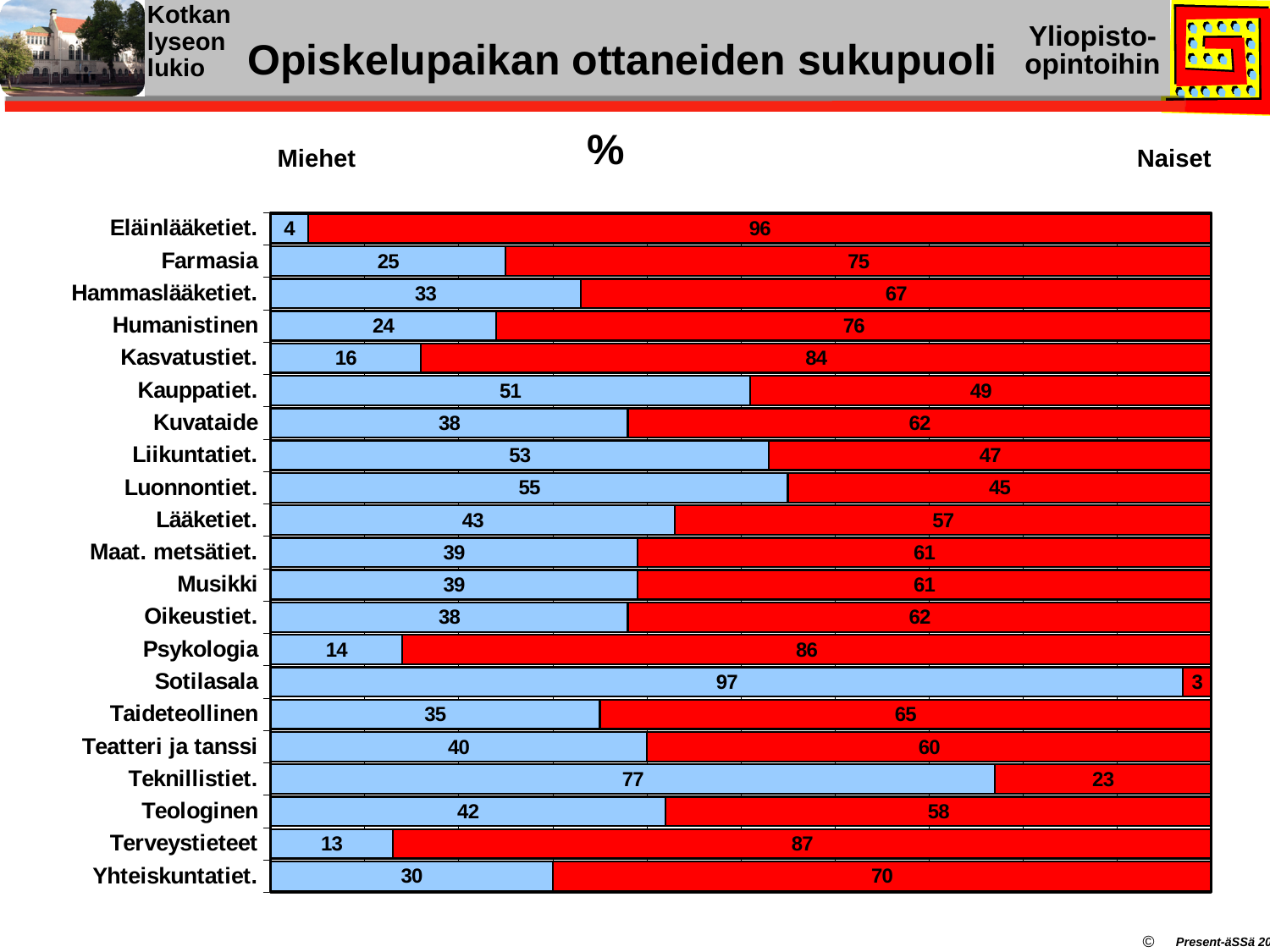
Which field has the highest Naiset (women) percentage? Eläinlääketiet. How many fields of study (categories) are listed on the chart? 21 Which has a larger Miehet percentage, Kauppatiet. or Yhteiskuntatiet.? Kauppatiet. What is the total of the Miehet and Naiset segments for Terveystieteet? 100 What is the difference between the Naiset and Miehet percentages for Psykologia? 72 Which field has the lowest Miehet (men) percentage? Eläinlääketiet. What type of chart is shown on the slide? stacked bar chart What is the Naiset (women) percentage for Eläinlääketiet.? 96 Which colour represents Naiset (women) in the chart? red What is the Miehet (men) percentage for Sotilasala? 97 What is the Naiset value for Teologinen? 58 What is the Miehet value for Teknillistiet.? 77